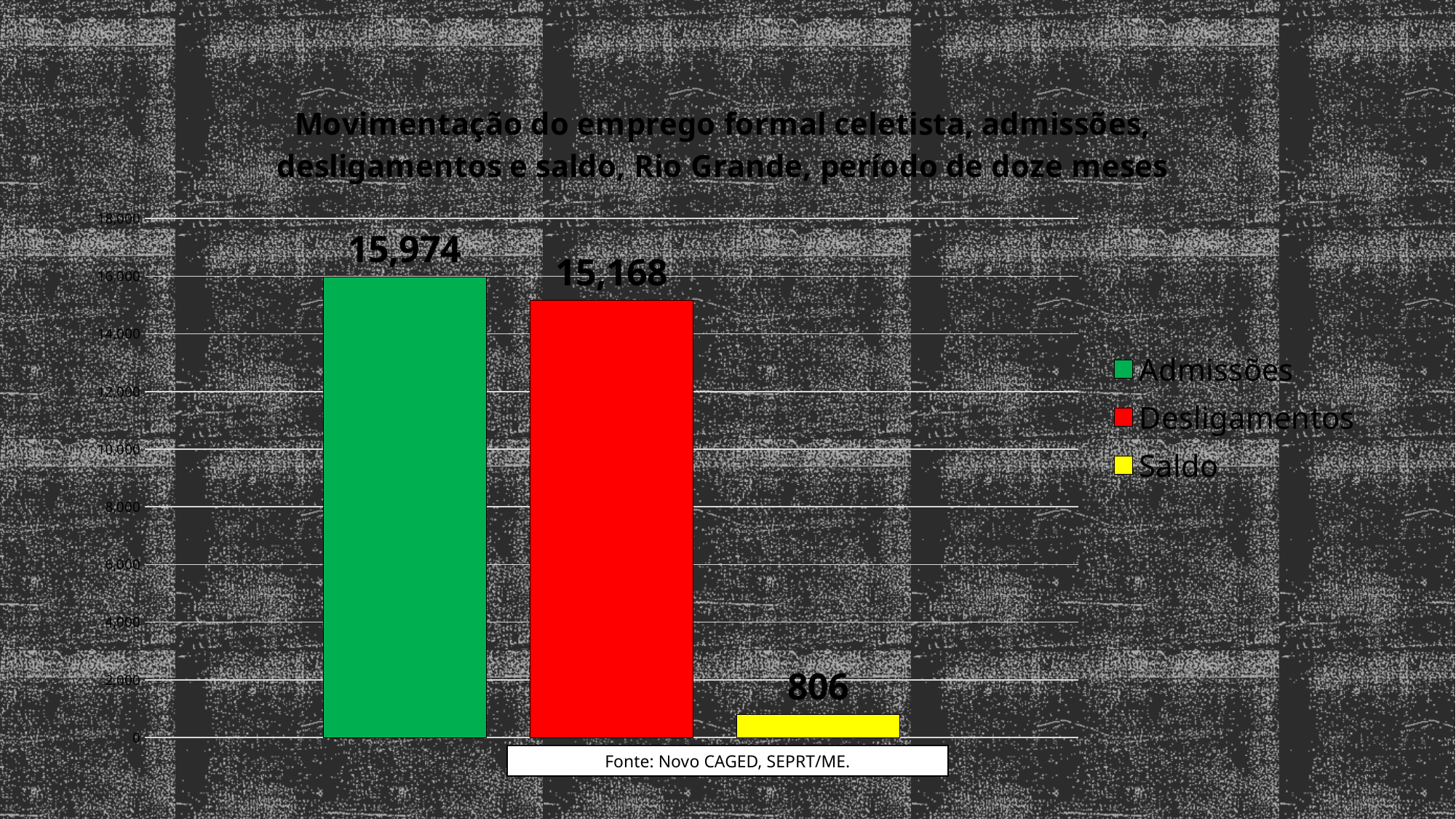
What is the value for Admissões? 15,974 How many series does the legend list? 3 Which series has the highest value? Admissões What colour is the Saldo bar? yellow What is the difference between Admissões and Desligamentos? 806 What is the value for Desligamentos? 15,168 Which series has the lowest value? Saldo What is the value for Saldo? 806 Is the value for Desligamentos greater or less than 16,000? less How many bars are plotted in the chart? 3 What kind of chart is shown on the slide? bar chart Which is larger, Admissões or Desligamentos? Admissões